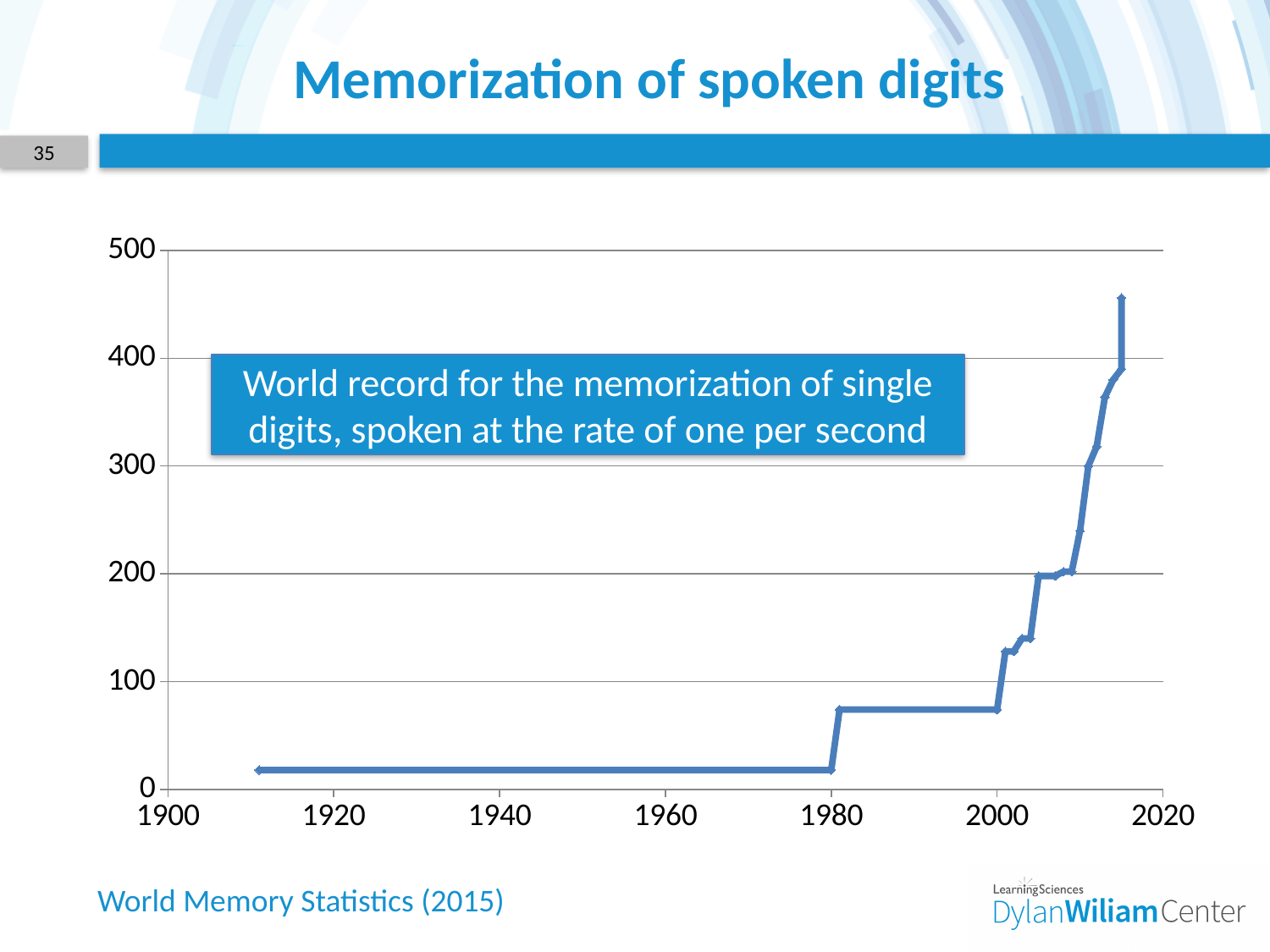
Do the values generally rise or fall as the years increase along the x axis? rise Which year has the larger value, 1940 or 2000? 2000 Is the value for 2000 greater or less than 100? less Is the highest value plotted on the chart greater or less than 400? greater What is the title of the slide containing the chart? Memorization of spoken digits What source is cited for the chart data? World Memory Statistics (2015) What kind of chart is shown on the slide? line chart Which year has the larger value, 1980 or 2000? 2000 Is the value for 1920 greater or less than 100? less